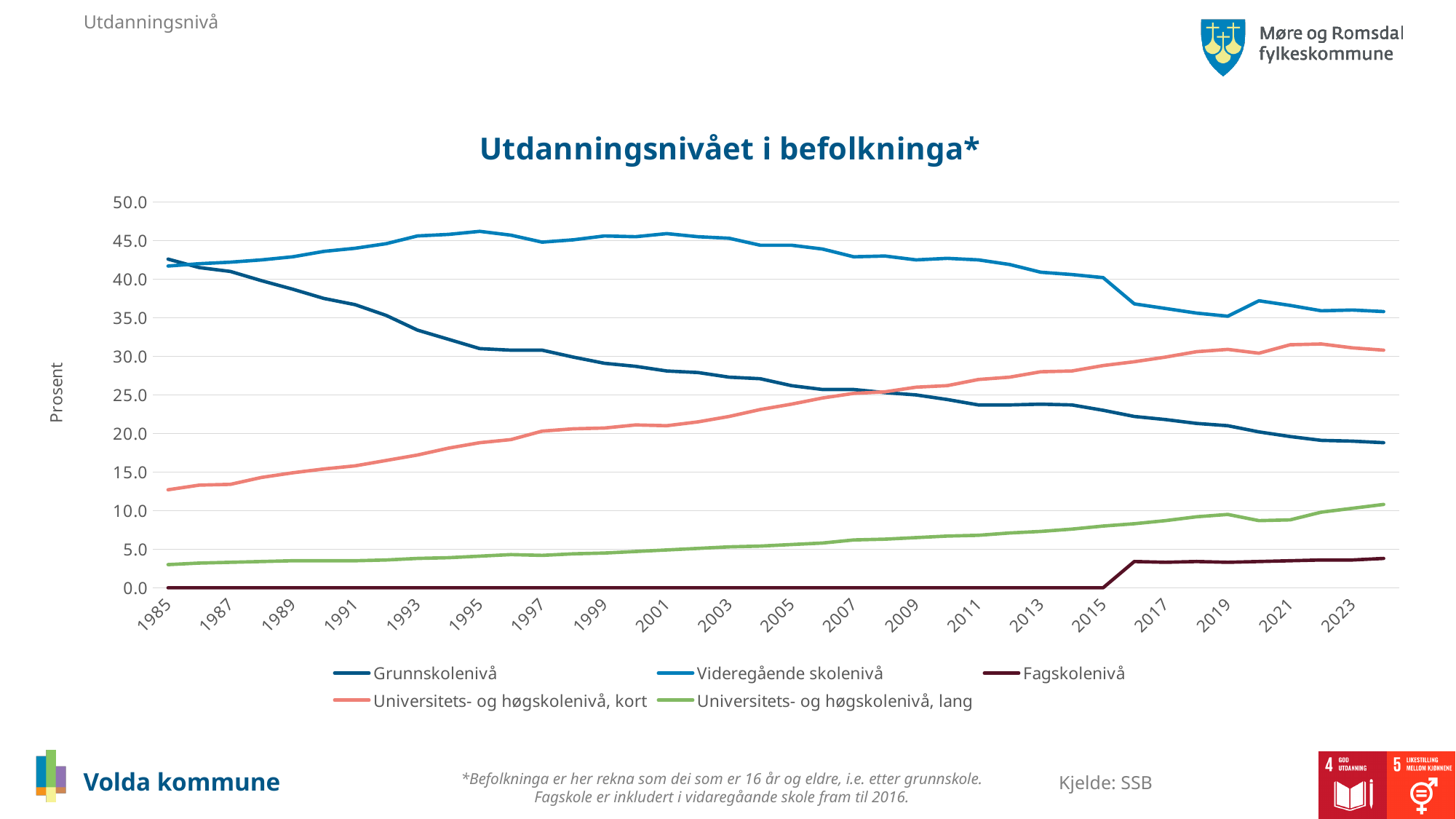
In 2023, which is higher: Grunnskolenivå or Universitets- og høgskolenivå, kort? Universitets- og høgskolenivå, kort Is the value for Grunnskolenivå in 2023 greater or less than 20.0? less Which series has the highest value in 2023? Videregående skolenivå What kind of chart is shown on the slide? Line chart How many series does the legend list? 5 What is the label on the vertical axis? Prosent Does the Universitets- og høgskolenivå, kort line rise or fall from 1985 to 2023? Rise Is the value for Universitets- og høgskolenivå, kort in 1985 greater or less than 15.0? less Does the Grunnskolenivå line rise or fall from 1985 to 2023? Fall What is the title of the chart? Utdanningsnivået i befolkninga* Is the value for Videregående skolenivå in 1995 greater or less than 45.0? greater What is the value for Fagskolenivå in 2010? 0.0